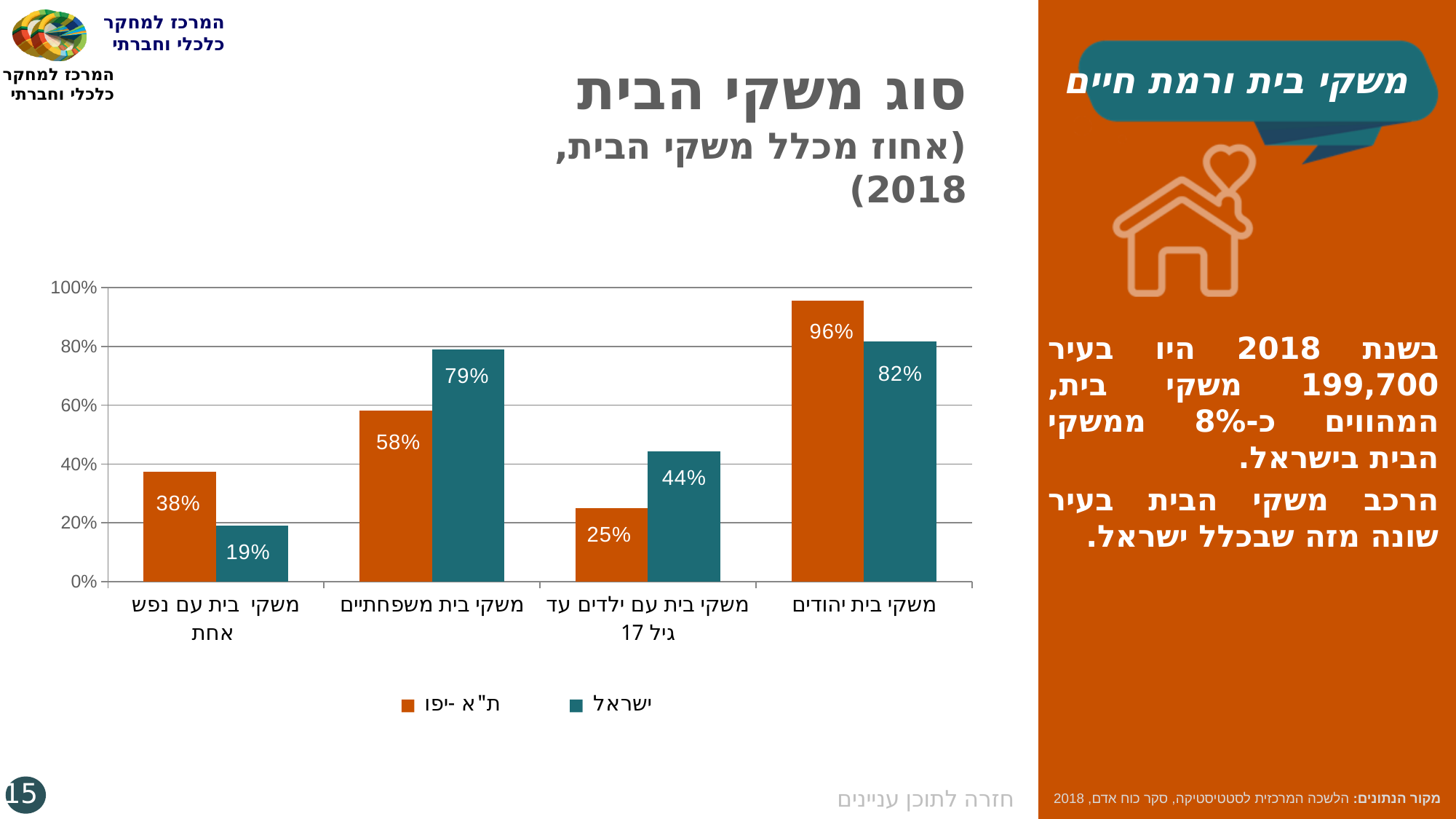
What is the value for ת"א -יפו in the category משקי בית עם נפש אחת? 38% What kind of chart is shown on the slide? bar chart What is the difference between the ישראל and ת"א -יפו values in the category משקי בית משפחתיים? 21% What is the value for ת"א -יפו in the category משקי בית יהודים? 96% Which category has the lowest value for the ישראל series? משקי בית עם נפש אחת What is the value for ישראל in the category משקי בית משפחתיים? 79% How many series does the chart legend list? 2 How many categories are shown on the x axis of the chart? 4 What is the sum of the ת"א -יפו and ישראל values in the category משקי בית עם נפש אחת? 57% What is the value for ישראל in the category משקי בית עם ילדים עד גיל 17? 44% Which category has the highest value for the ת"א -יפו series? משקי בית יהודים In the category משקי בית עם ילדים עד גיל 17, which series has the larger value, ת"א -יפו or ישראל? ישראל